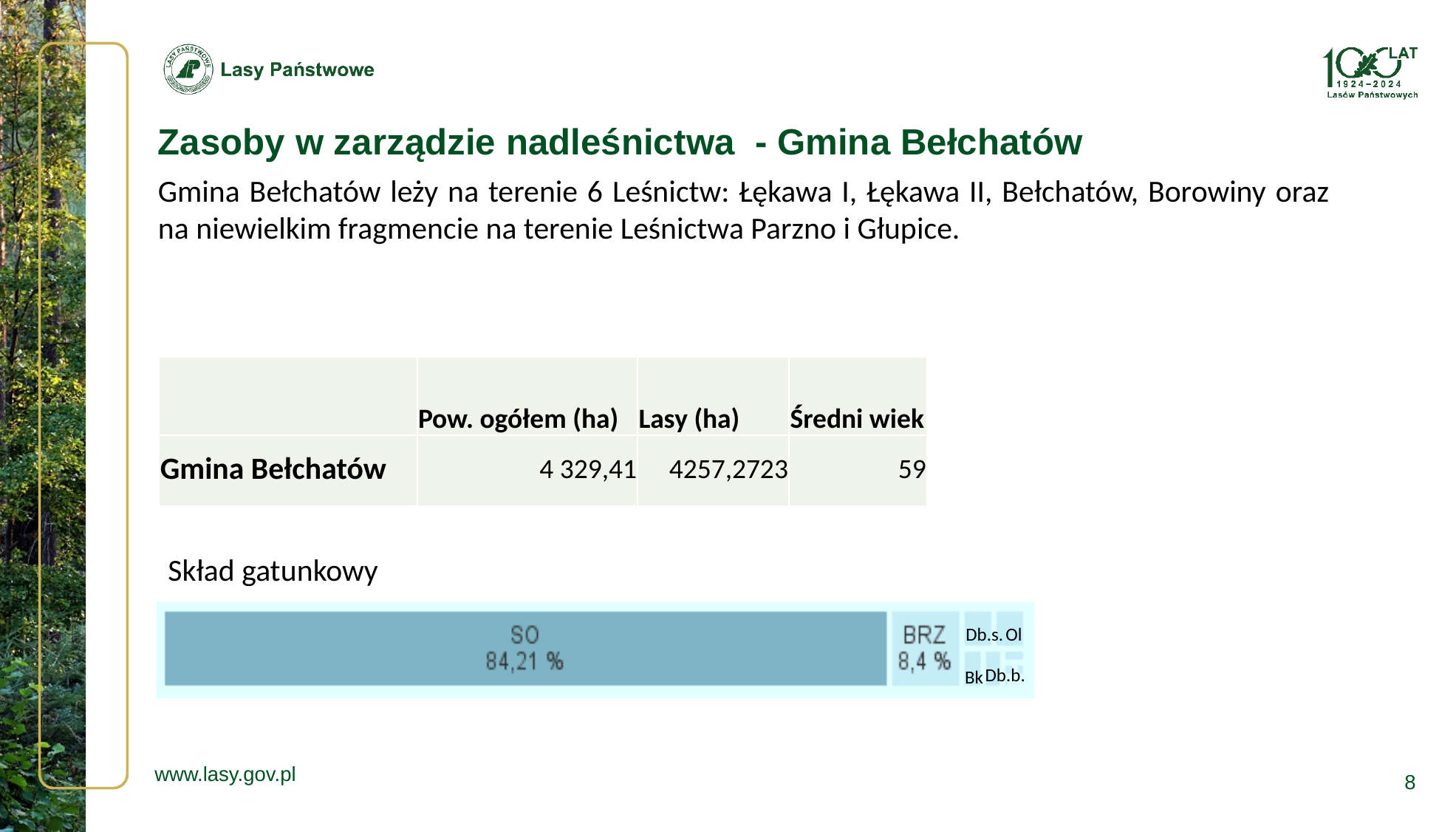
How many species labels are shown in the 'Skład gatunkowy' chart? 6 In the 'Skład gatunkowy' chart, which species has the largest share? SO What is the title of the chart on the slide? Skład gatunkowy In the 'Skład gatunkowy' chart, what percentage is shown for SO? 84,21 % In the 'Skład gatunkowy' chart, which species labels appear in the small area to the right of BRZ? Db.s., Ol, Bk, Db.b. In the 'Skład gatunkowy' chart, what percentage is shown for BRZ? 8,4 % In the 'Skład gatunkowy' chart, which has the larger share, SO or BRZ? SO In the 'Skład gatunkowy' chart, which has the larger share, BRZ or Bk? BRZ In the 'Skład gatunkowy' chart, what is the difference between the shares of SO and BRZ? 75,81 %